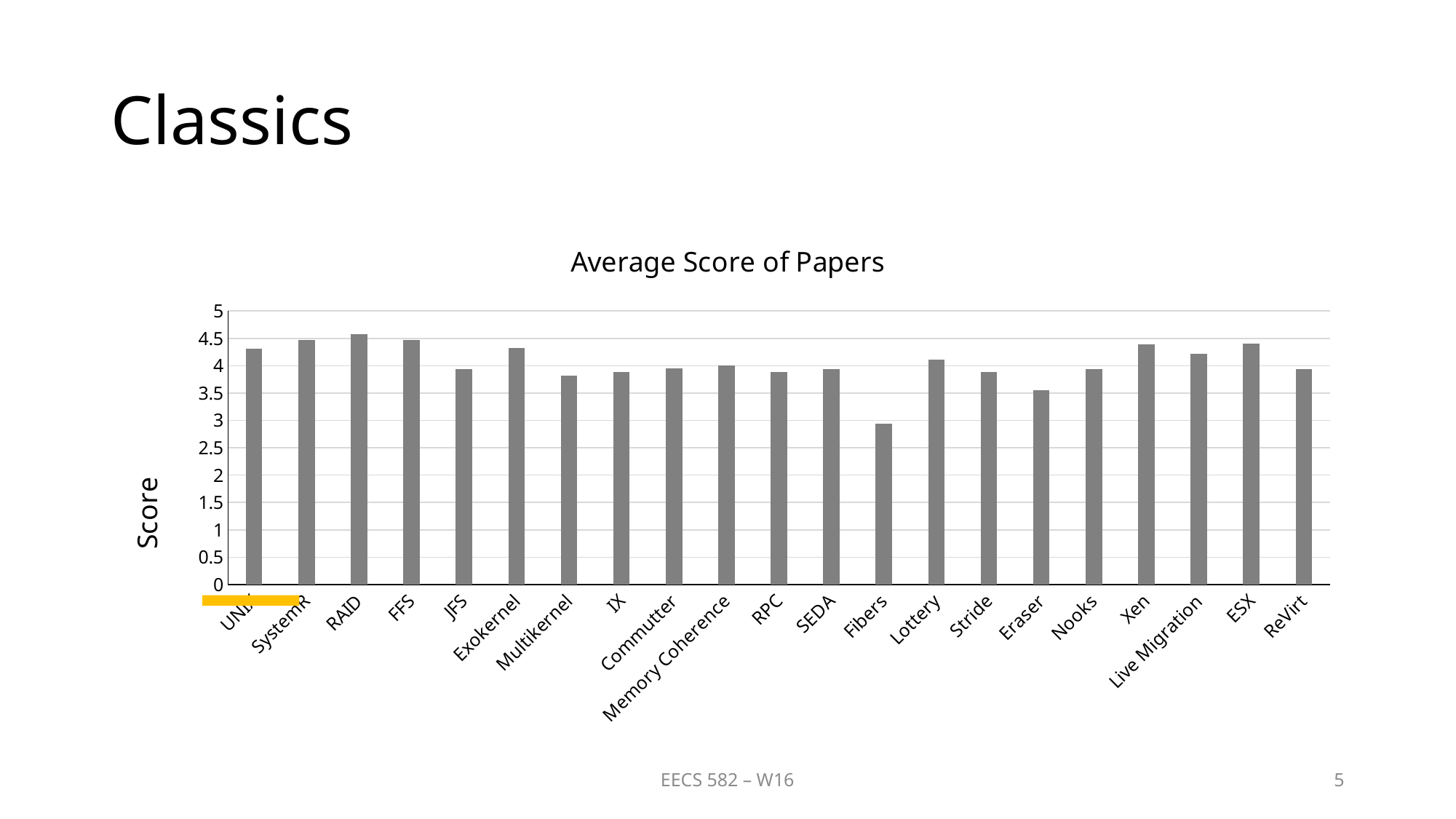
Is the value for Eraser greater or less than 4? less Which paper has the lowest average score? Fibers Which has the larger average score, RAID or Eraser? RAID What kind of chart is shown on the slide? bar chart Which has the larger average score, Eraser or Fibers? Eraser What is the label on the vertical axis of the chart? Score Is the value for Multikernel greater or less than 4? less What is the title of the chart? Average Score of Papers How many papers (bars) are shown in the chart? 21 Is the value for Xen greater or less than 4? greater